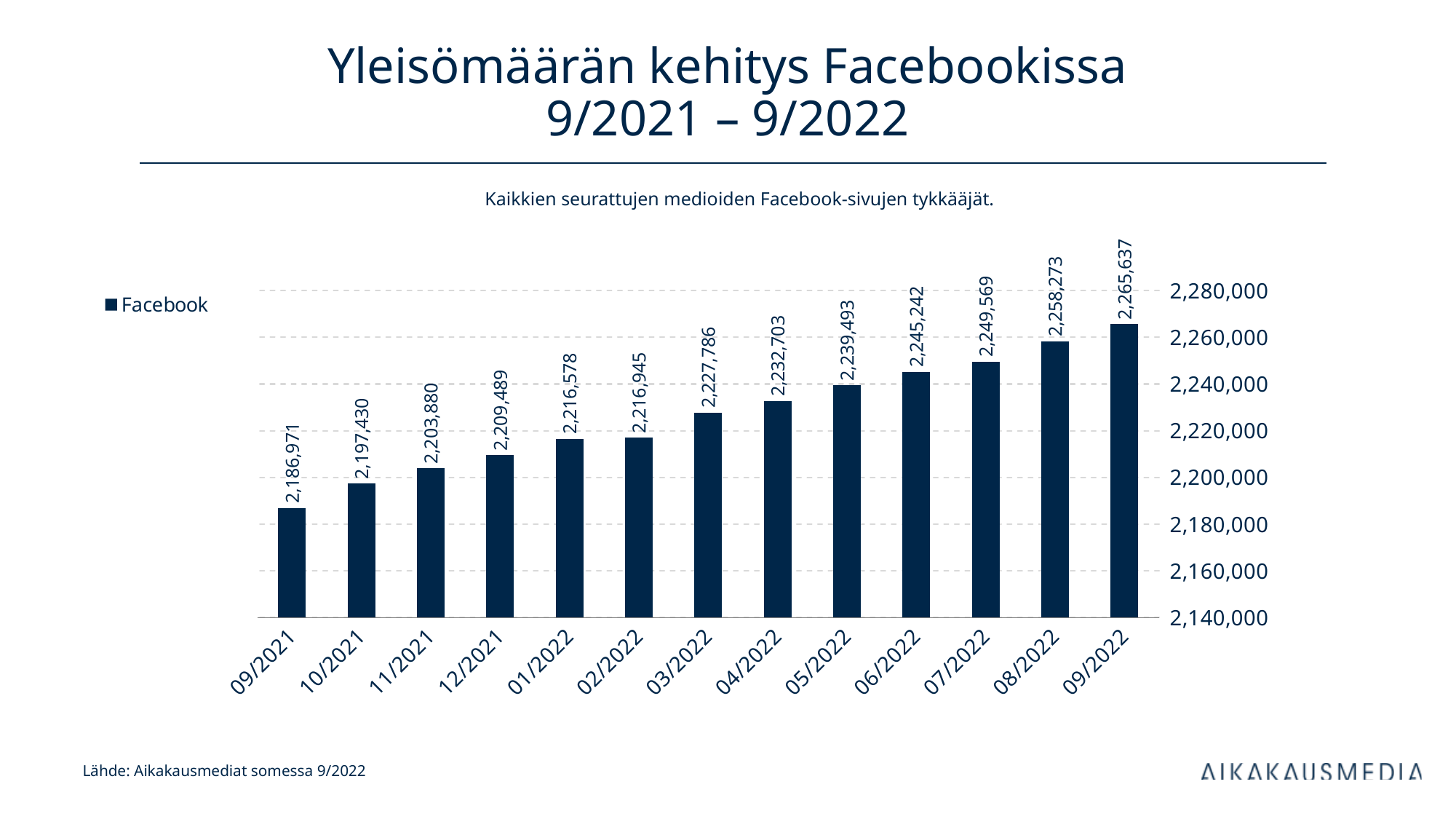
How many months are shown on the x axis? 13 How many series does the legend list? 1 What kind of chart is shown on the slide? bar chart Which month has the lowest value? 09/2021 What is the value for 03/2022? 2,227,786 What is the difference between the values for 08/2022 and 07/2022? 8,704 What is the value for 09/2021? 2,186,971 What is the difference between the values for 09/2022 and 09/2021? 78,666 What is the value for 09/2022? 2,265,637 Is the value for 12/2021 greater or less than 2,220,000? less Which is larger, the value for 05/2022 or the value for 11/2021? 05/2022 Which month has the highest value? 09/2022